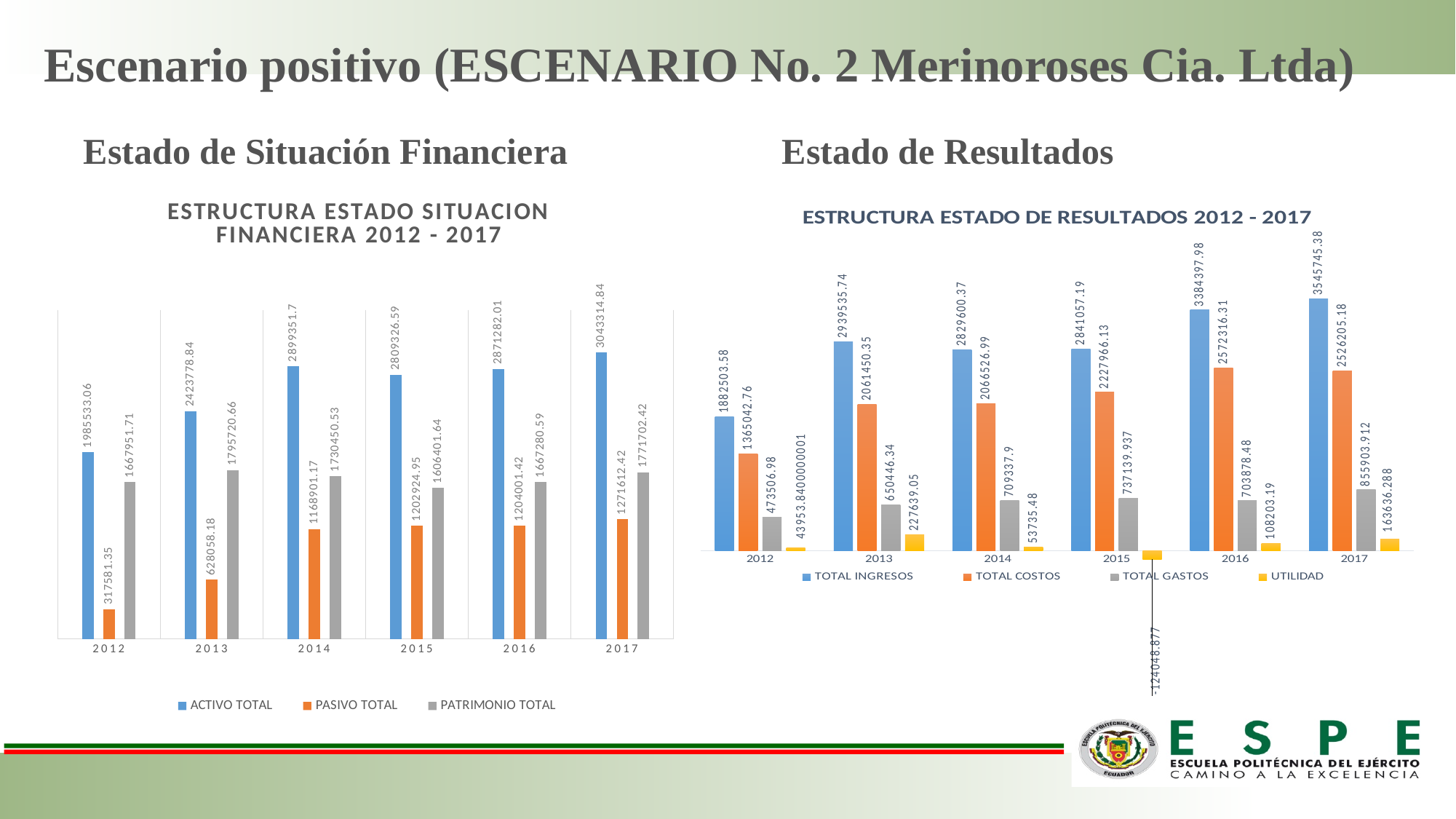
In the ESTRUCTURA ESTADO SITUACION FINANCIERA 2012 - 2017 chart, which year has the highest PASIVO TOTAL? 2017 In the ESTRUCTURA ESTADO SITUACION FINANCIERA 2012 - 2017 chart, what is the ACTIVO TOTAL value for 2014? 2899351.7 In the ESTRUCTURA ESTADO SITUACION FINANCIERA 2012 - 2017 chart, what is the difference between ACTIVO TOTAL and PASIVO TOTAL in 2017? 1771702.42 What type of chart is the ESTRUCTURA ESTADO DE RESULTADOS 2012 - 2017 chart? Bar chart In the ESTRUCTURA ESTADO SITUACION FINANCIERA 2012 - 2017 chart, what is the PASIVO TOTAL value for 2012? 317581.35 In the ESTRUCTURA ESTADO SITUACION FINANCIERA 2012 - 2017 chart, which year has the lowest ACTIVO TOTAL? 2012 In the ESTRUCTURA ESTADO DE RESULTADOS 2012 - 2017 chart, which is larger in 2013: TOTAL COSTOS or TOTAL GASTOS? TOTAL COSTOS In the ESTRUCTURA ESTADO DE RESULTADOS 2012 - 2017 chart, which year has the lowest UTILIDAD? 2015 In the ESTRUCTURA ESTADO DE RESULTADOS 2012 - 2017 chart, what is the UTILIDAD value for 2015? -124048.877 In the ESTRUCTURA ESTADO DE RESULTADOS 2012 - 2017 chart, which year has the highest TOTAL INGRESOS? 2017 In the ESTRUCTURA ESTADO DE RESULTADOS 2012 - 2017 chart, what is the TOTAL INGRESOS value for 2016? 3384397.98 In the ESTRUCTURA ESTADO SITUACION FINANCIERA 2012 - 2017 chart, how many series does the legend list? 3